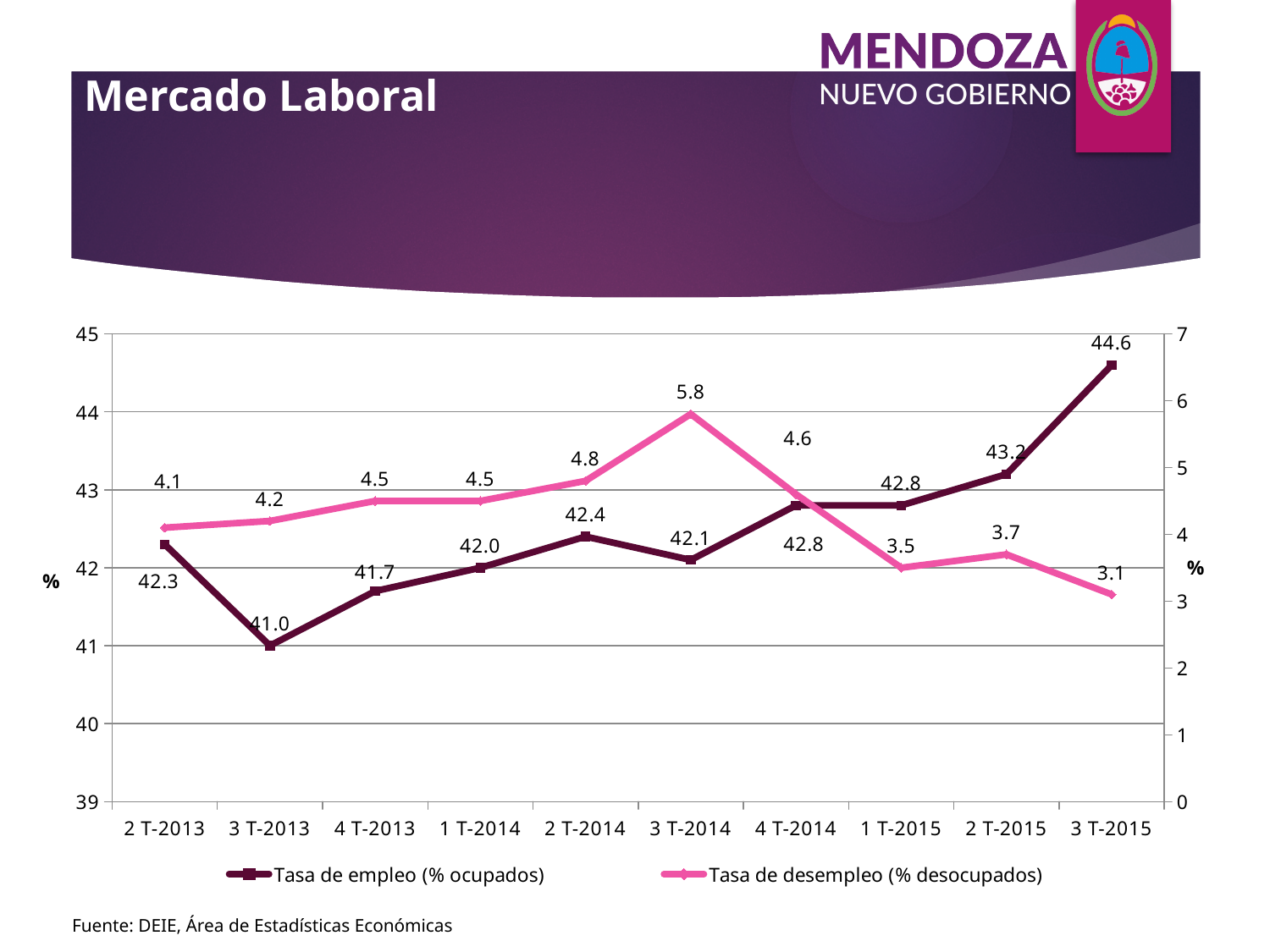
What is the Tasa de empleo (% ocupados) value for 3 T-2013? 41.0 In which quarter is the Tasa de desempleo (% desocupados) highest? 3 T-2014 Which is larger, the Tasa de desempleo for 2 T-2014 or for 1 T-2015? 2 T-2014 What kind of chart is shown on the slide? Line chart In which quarter is the Tasa de empleo (% ocupados) lowest? 3 T-2013 Does the Tasa de desempleo (% desocupados) rise or fall from 3 T-2014 to 3 T-2015? Fall What is the Tasa de desempleo (% desocupados) value for 3 T-2014? 5.8 How many series does the legend list? 2 What is the Tasa de empleo (% ocupados) value for 3 T-2015? 44.6 How many quarters are shown on the x axis? 10 What is the difference between the Tasa de empleo values for 3 T-2015 and 3 T-2013? 3.6 In which quarter is the Tasa de desempleo (% desocupados) lowest? 3 T-2015